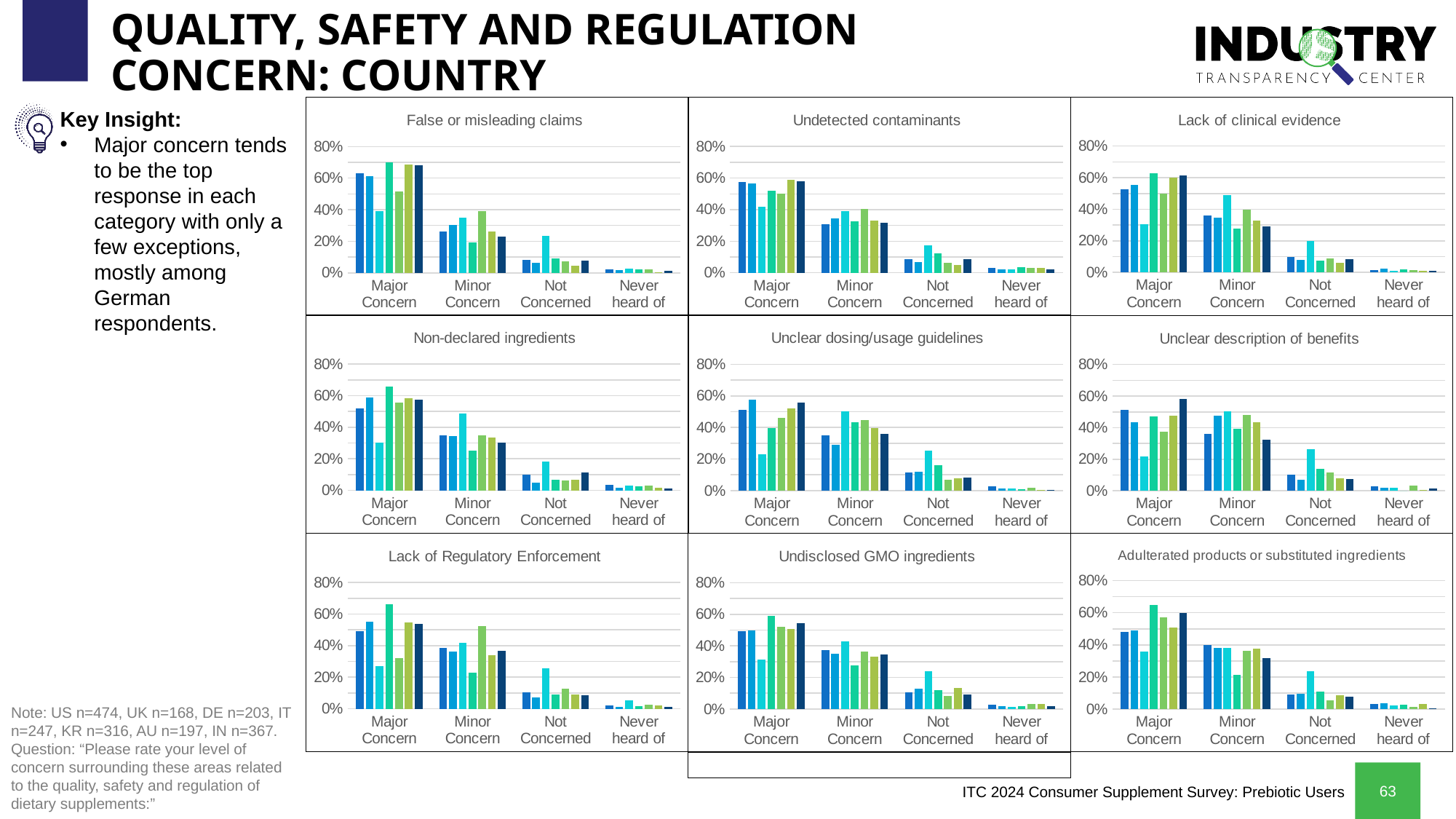
How many categories are shown on the x axis of the 'Undetected contaminants' chart? 4 In the 'Unclear dosing/usage guidelines' chart, which category has the lowest values? Never heard of What kind of chart is the 'False or misleading claims' chart? bar chart In the 'Non-declared ingredients' chart, which category has the tallest bars? Major Concern What is the title of the chart in the bottom-right position of the slide? Adulterated products or substituted ingredients In the 'Lack of clinical evidence' chart, do the values generally rise or fall moving from Major Concern to Never heard of? fall In the 'Undisclosed GMO ingredients' chart, is the tallest bar in the Not Concerned group greater or less than 20%? greater In the 'Unclear description of benefits' chart, is the tallest bar in the Major Concern group greater or less than 40%? greater In the 'Lack of Regulatory Enforcement' chart, is the tallest bar in the Major Concern group or the tallest bar in the Minor Concern group higher? Major Concern In the 'Undetected contaminants' chart, is the tallest bar in the Never heard of group greater or less than 20%? less How many bar charts are shown on the slide? 9